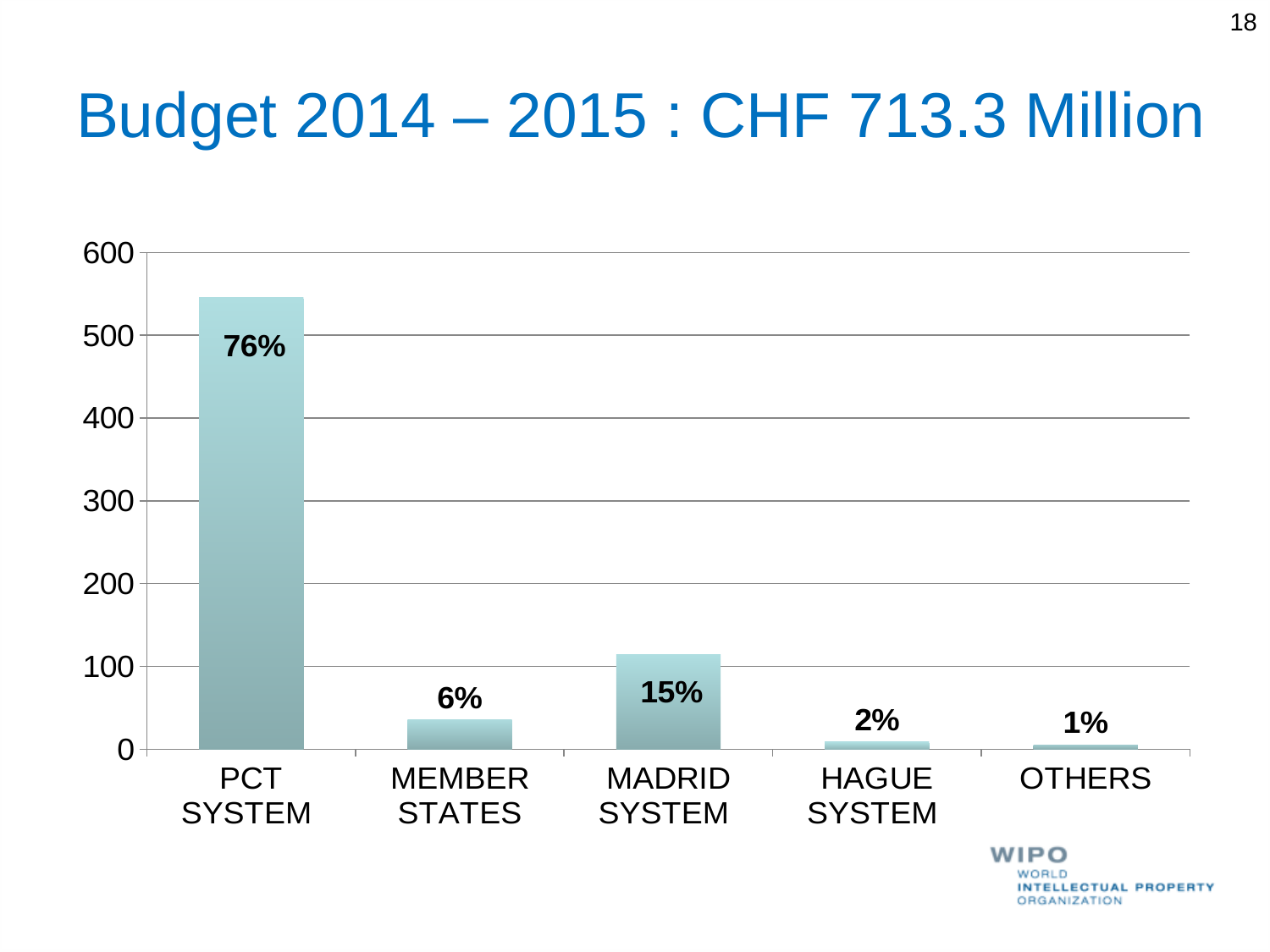
What percentage label is shown on the MADRID SYSTEM bar? 15% What kind of chart is shown on the slide? Bar chart What percentage label is shown on the HAGUE SYSTEM bar? 2% Is the value for PCT SYSTEM greater or less than 500? greater How many categories are shown on the x axis? 5 Which category has the highest bar? PCT SYSTEM Is the value for MADRID SYSTEM greater or less than 100? greater What is the difference in percentage points between the PCT SYSTEM label and the MADRID SYSTEM label? 61% What percentage label is shown on the MEMBER STATES bar? 6% What percentage label is shown on the PCT SYSTEM bar? 76% Which is larger, the bar for MEMBER STATES or the bar for MADRID SYSTEM? MADRID SYSTEM Which category has the lowest bar? OTHERS